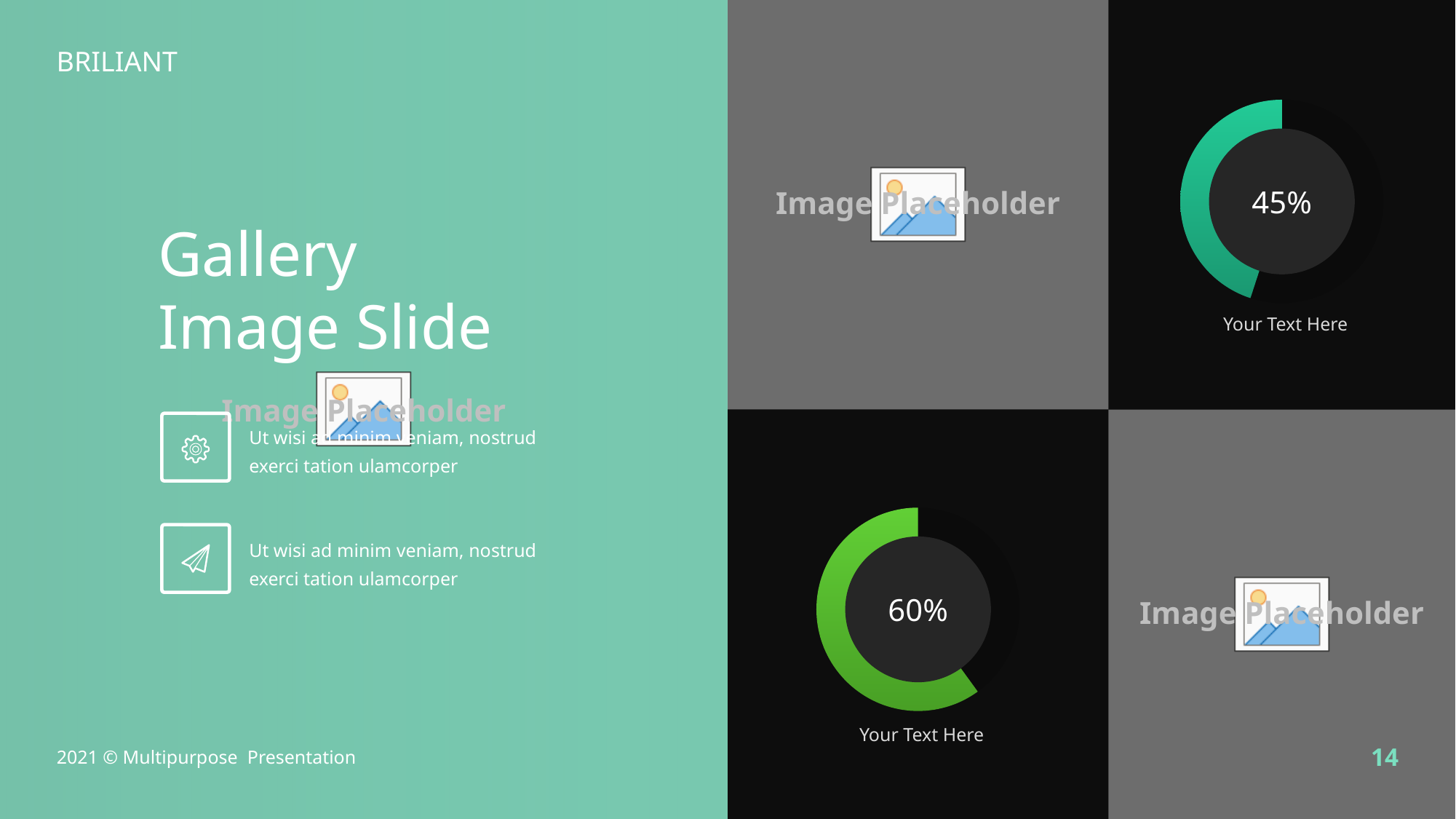
Which donut chart shows the lowest percentage? the top-right chart (45%) What text label appears below the bottom donut chart? Your Text Here What is the difference between the percentage in the bottom donut chart and the percentage in the top-right donut chart? 15% What percentage is shown in the centre of the bottom donut chart? 60% What kind of chart is used to display the 45% and 60% values? donut chart What percentage is shown in the centre of the top-right donut chart? 45% Is the value in the top-right donut chart greater or less than 50%? less Which of the two donut charts shows the larger percentage, the top-right one or the bottom one? the bottom one (60%) What colour is the filled ring of the bottom donut chart showing 60%? green How many donut charts are on the slide? 2 Is the value in the bottom donut chart greater or less than 50%? greater